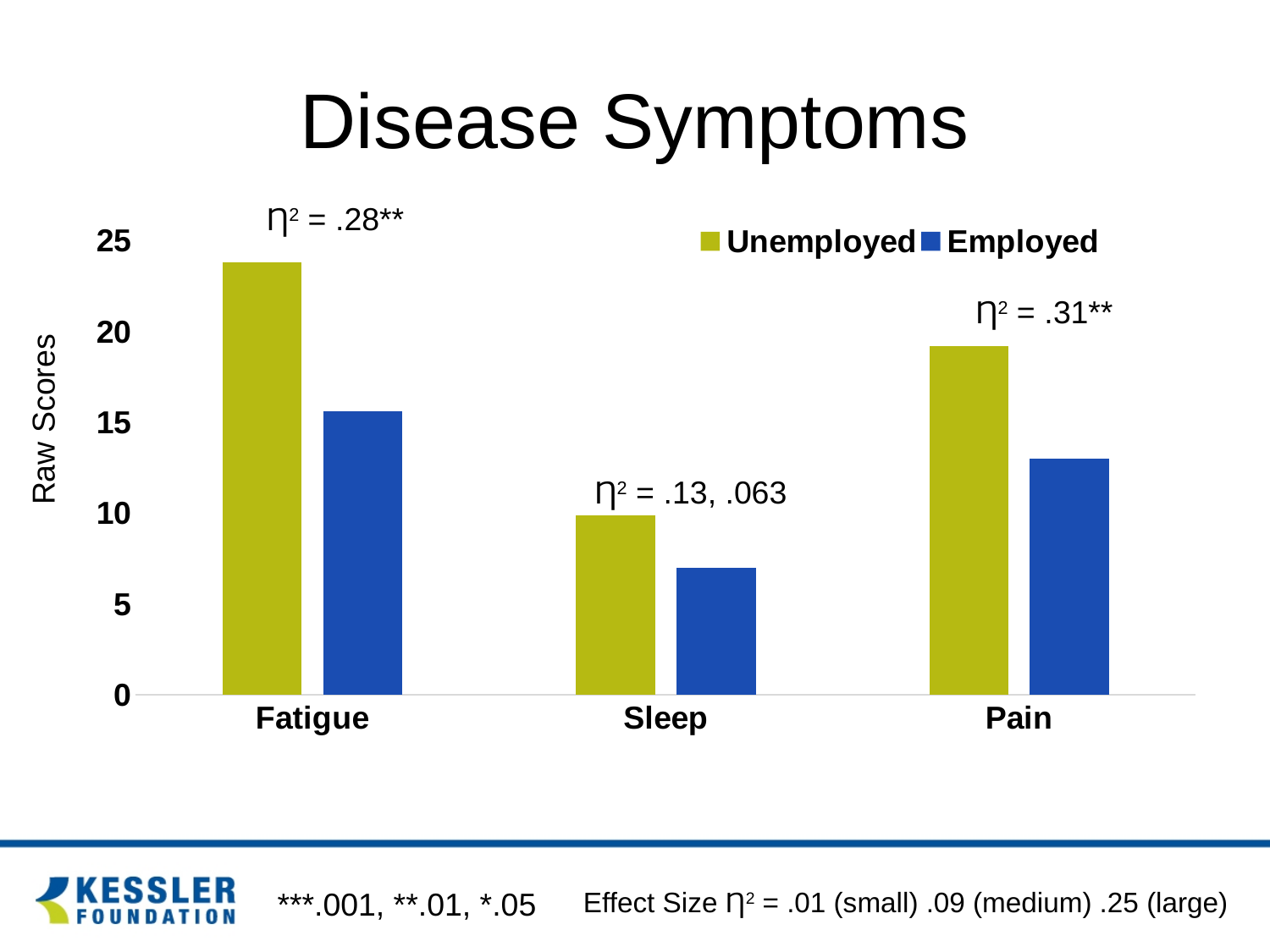
What kind of chart is shown on the slide? bar chart Which category has the lowest Employed value? Sleep How many series does the chart's legend list? 2 Which category has the highest Unemployed value? Fatigue Is the Unemployed value for Pain greater or less than 15? greater What is the title of the chart? Disease Symptoms Is the Employed value for Sleep greater or less than 10? less For Fatigue, which group has the larger value, Unemployed or Employed? Unemployed How many categories are shown on the x axis of the chart? 3 Is the Employed value for Pain greater or less than 10? greater What is the label on the y axis of the chart? Raw Scores